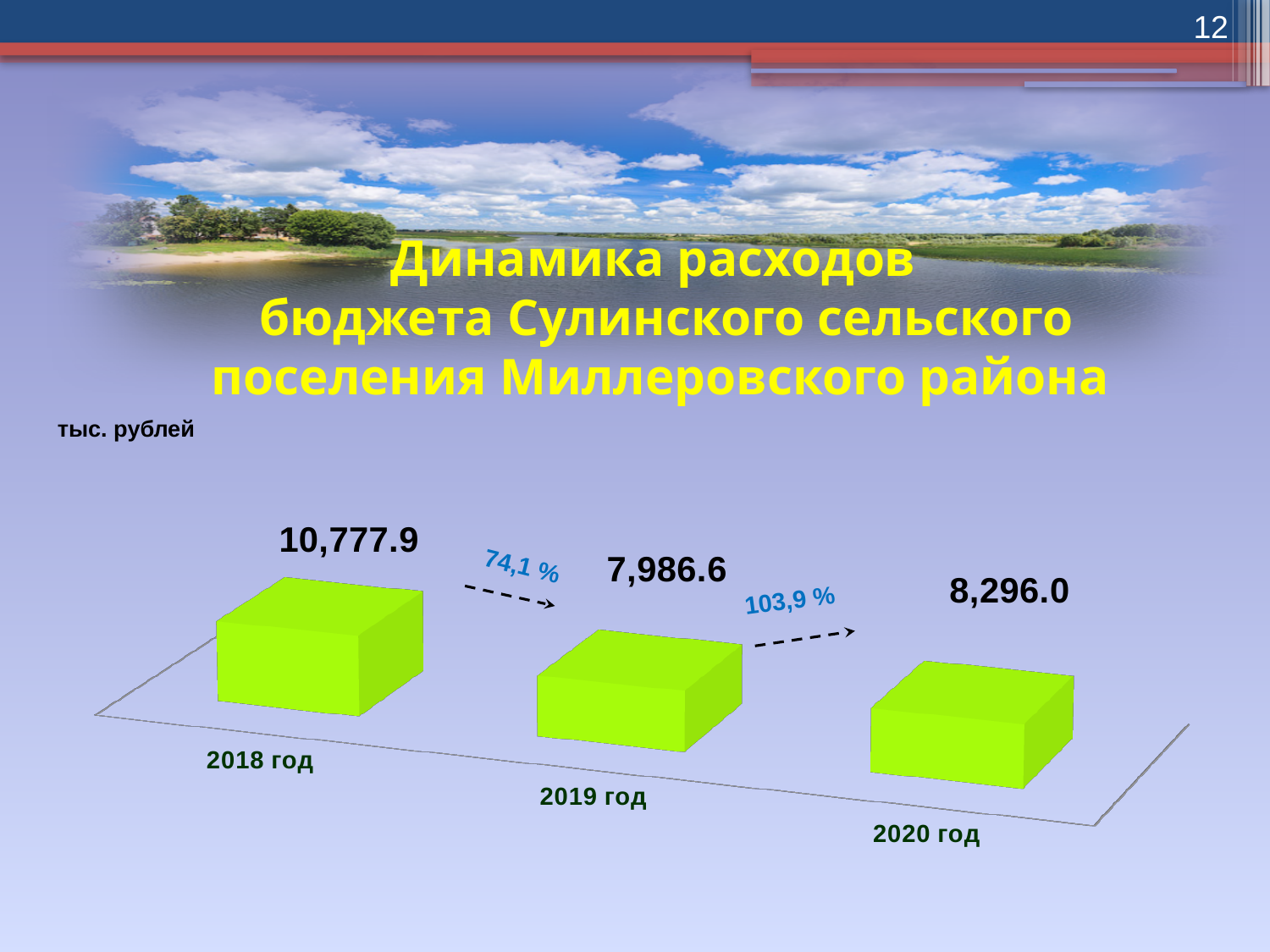
What is the budget expenditure value shown for 2019 год? 7,986.6 What is the budget expenditure value shown for 2018 год? 10,777.9 Which is larger, the expenditure value for 2020 год or for 2019 год? 2020 год What is the budget expenditure value shown for 2020 год? 8,296.0 In what units are the chart values expressed, according to the label on the slide? тыс. рублей What is the difference between the expenditure values for 2020 год and 2019 год? 309.4 How many years (bars) are shown on the chart? 3 Which year has the lowest expenditure value on the chart? 2019 год Which year has the highest expenditure value on the chart? 2018 год What kind of chart is shown on the slide? Bar chart What percentage change is shown between 2019 год and 2020 год? 103,9 % What is the difference between the expenditure values for 2018 год and 2019 год? 2,791.3